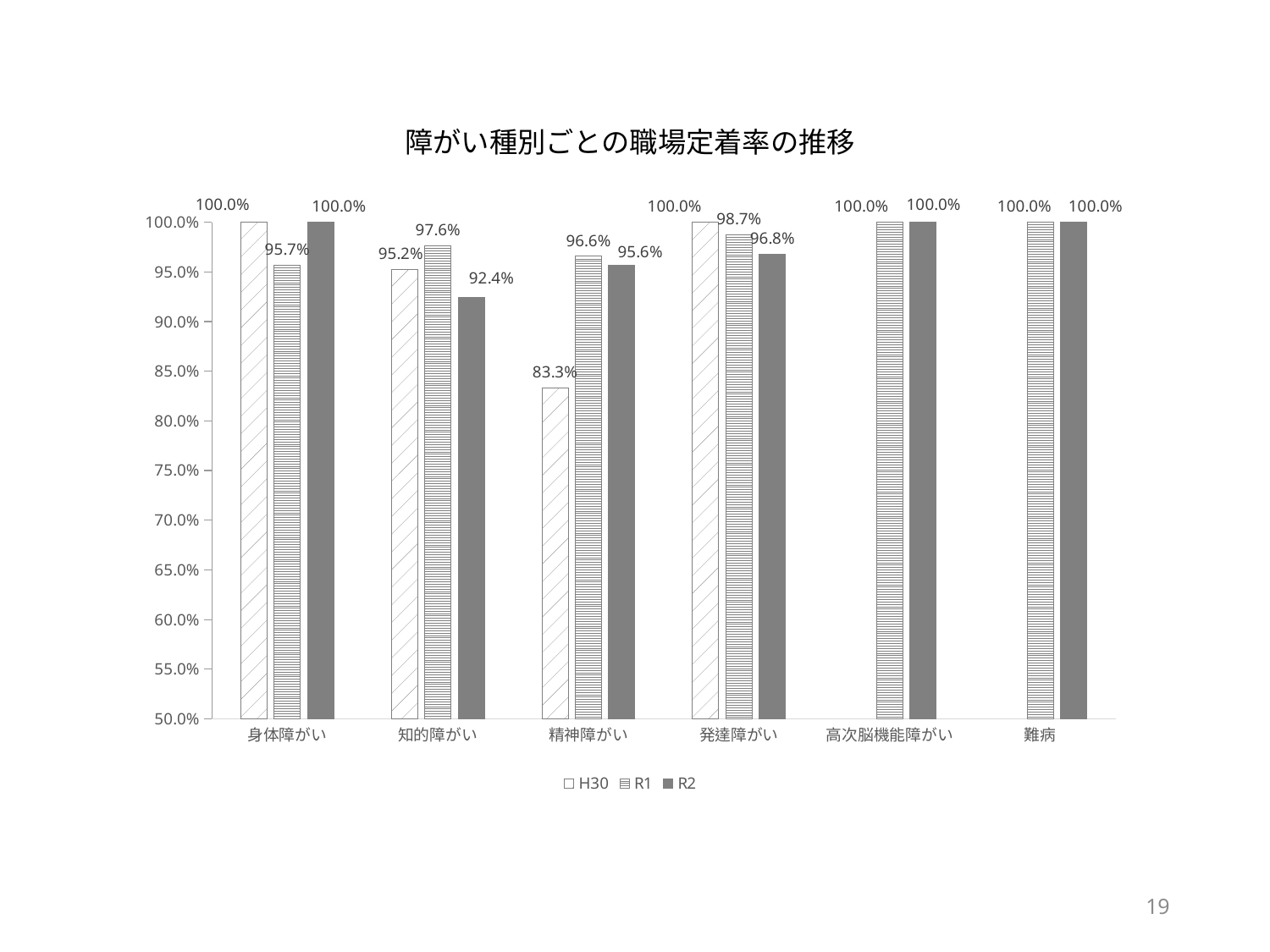
How many categories are shown on the x axis? 6 Which category has the lowest R2 value? 知的障がい How many series does the legend list? 3 What is the difference between the R1 and H30 values for 精神障がい? 13.3% What is the R1 value for 知的障がい? 97.6% What is the R2 value for 発達障がい? 96.8% What is the H30 value for 精神障がい? 83.3% What is the difference between the H30 and R2 values for 知的障がい? 2.8% What is the R1 value for 身体障がい? 95.7% What type of chart is shown on the slide? Bar chart Which is larger for 発達障がい, the R1 value or the R2 value? R1